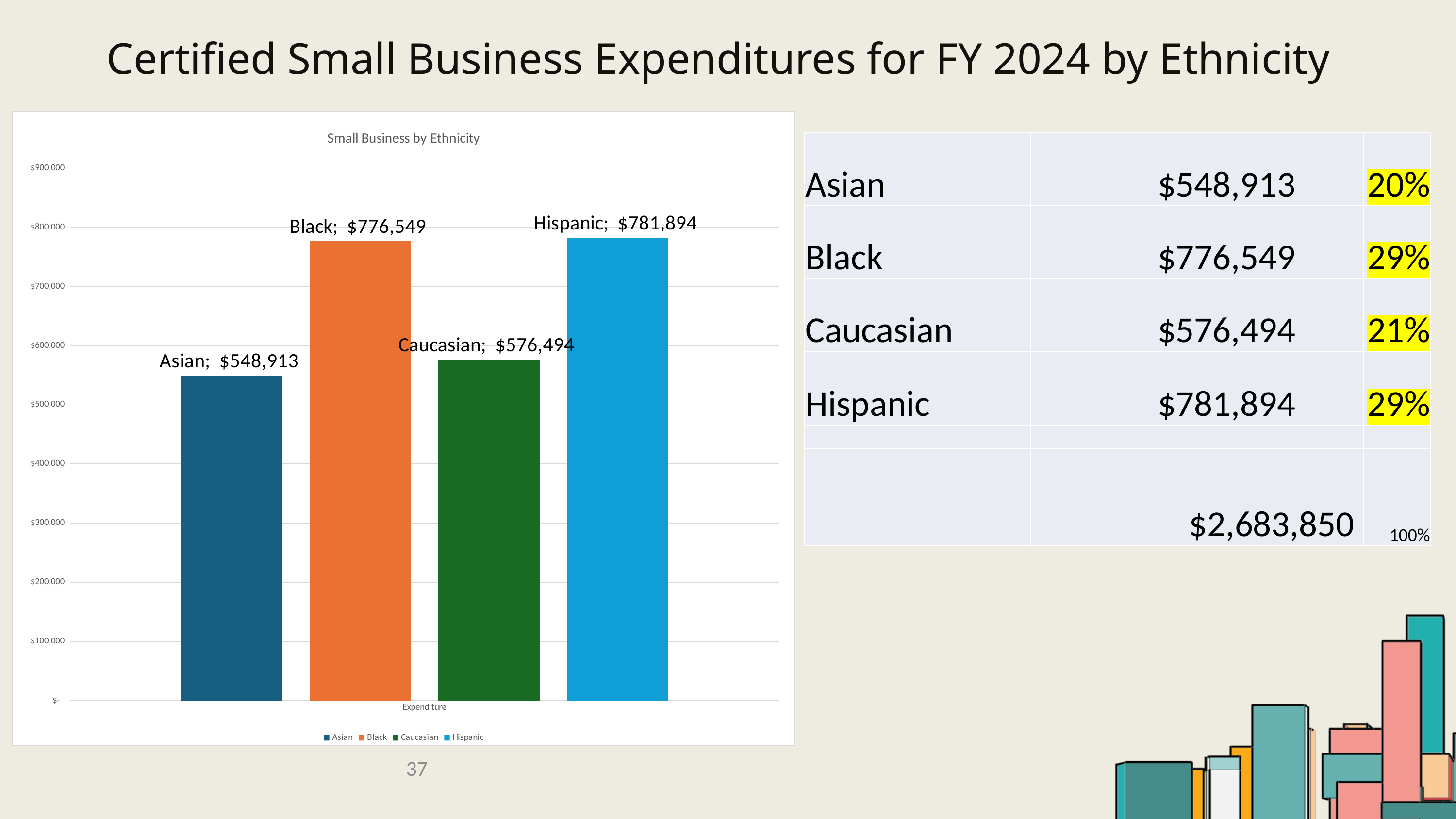
What type of chart is shown on the slide? bar chart What is the value for Caucasian in the chart? $576,494 How many bars are plotted in the chart? 4 What is the difference between the Hispanic and Caucasian values in the chart? $205,400 What is the difference between the Black and Asian values in the chart? $227,636 What is the value for Hispanic in the chart? $781,894 Which is larger in the chart, the value for Black or the value for Caucasian? Black What is the value for Asian in the chart? $548,913 Is the value for Asian greater or less than $500,000? greater How many series does the chart legend list? 4 Which ethnicity has the highest expenditure in the chart? Hispanic Which ethnicity has the lowest expenditure in the chart? Asian